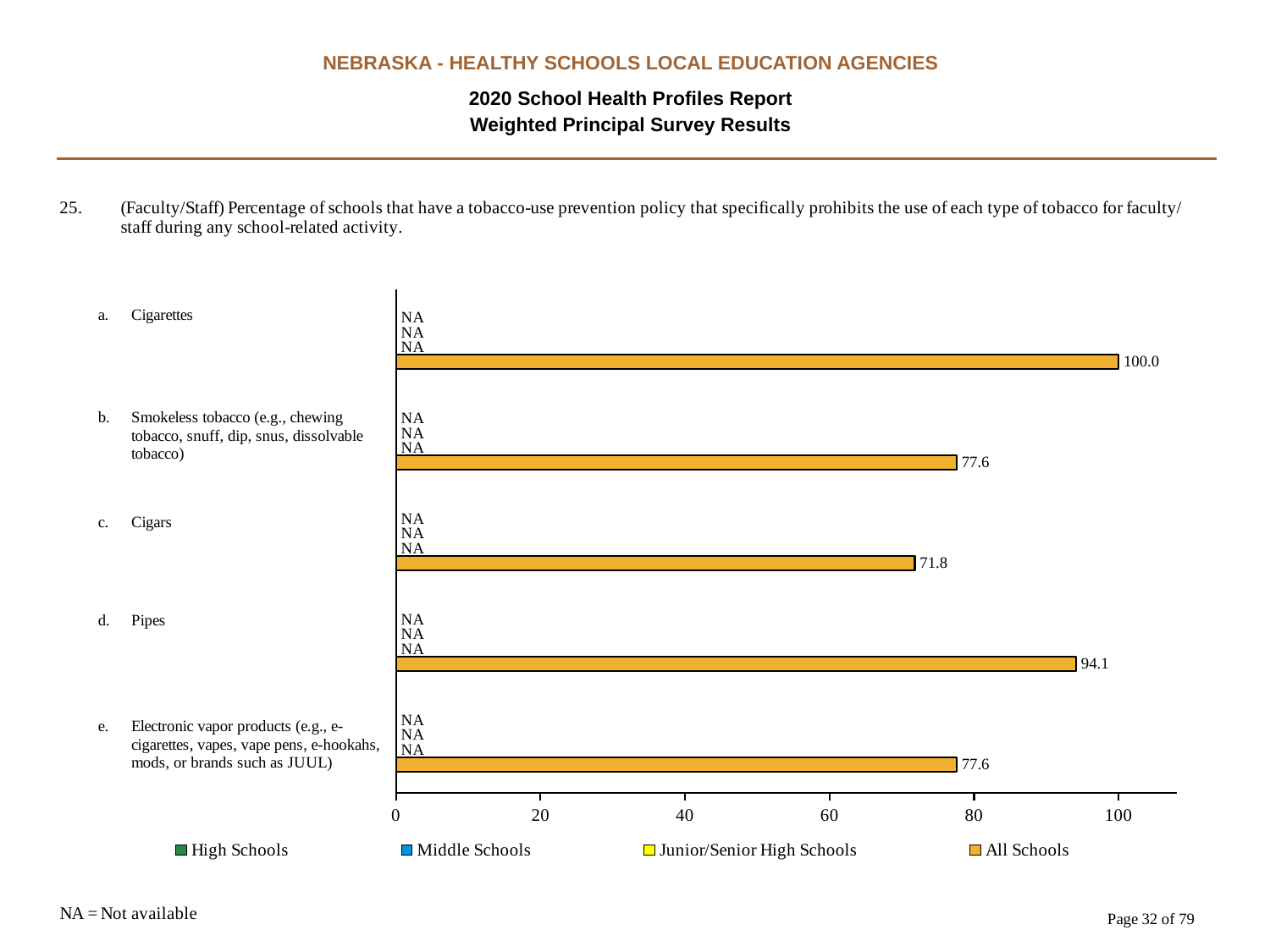
Which category has the highest All Schools value? Cigarettes What is the All Schools value for Pipes? 94.1 What is the All Schools value for Cigarettes? 100.0 What is the All Schools value for Cigars? 71.8 Which category has the lowest All Schools value? Cigars Is the All Schools value for Cigars greater or less than 80? less Which has a larger All Schools value, Pipes or Smokeless tobacco? Pipes How many series does the legend list? 4 What kind of chart is shown on the slide? bar chart What is the All Schools value for Electronic vapor products? 77.6 How many tobacco categories are shown in the chart? 5 What is the difference between the All Schools values for Cigarettes and Pipes? 5.9